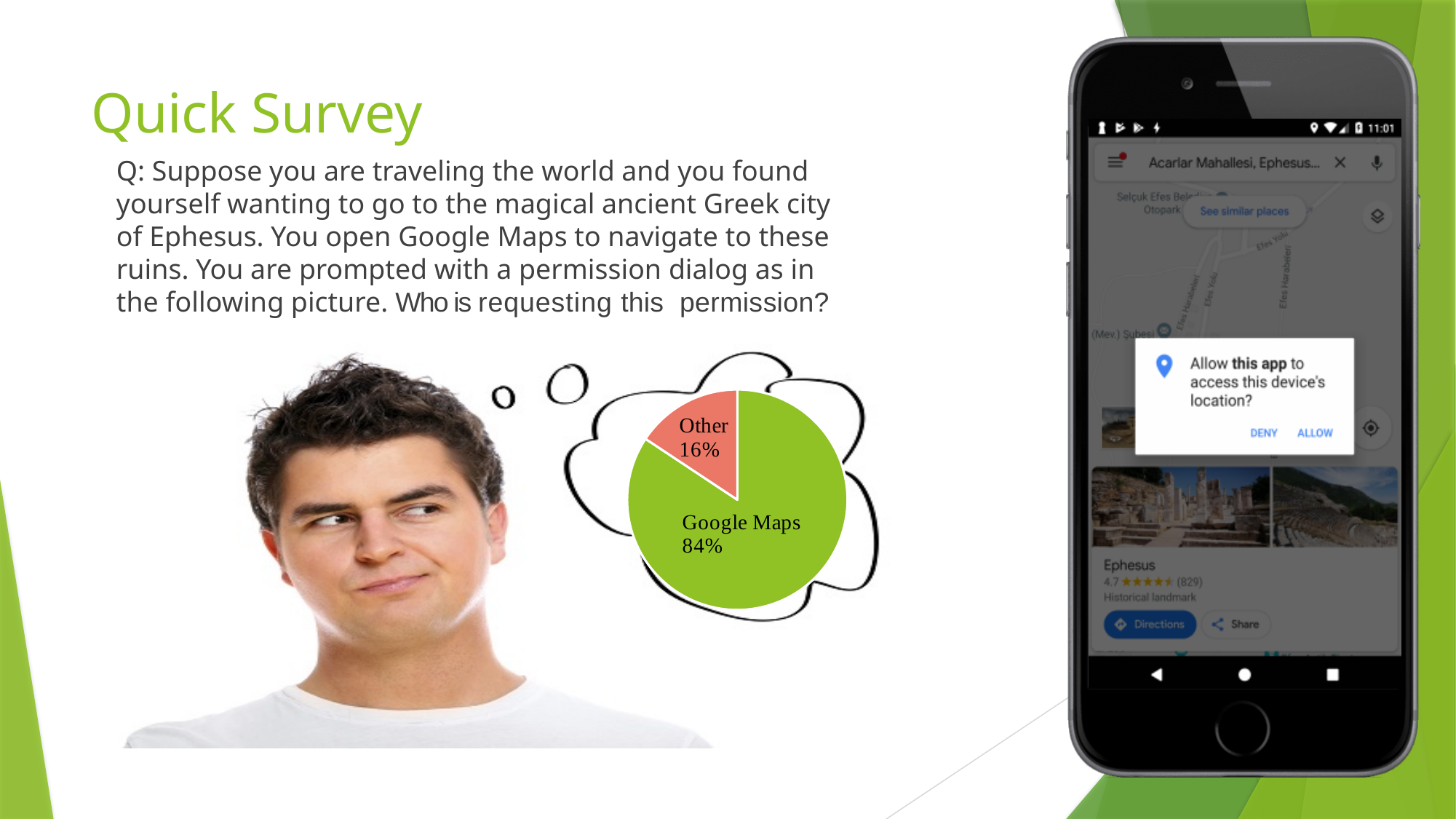
What colour is the Google Maps slice of the pie? green What share of the pie does Google Maps have? 84% Which is larger, the Google Maps slice or the Other slice? Google Maps Which slice of the pie is the smallest? Other What colour is the Other slice of the pie? red What kind of chart is shown inside the thought bubble? pie chart How many slices does the pie chart have? 2 Which slice of the pie is the largest? Google Maps What is the difference in percentage points between the Google Maps slice and the Other slice? 68 What share of the pie does Other have? 16%